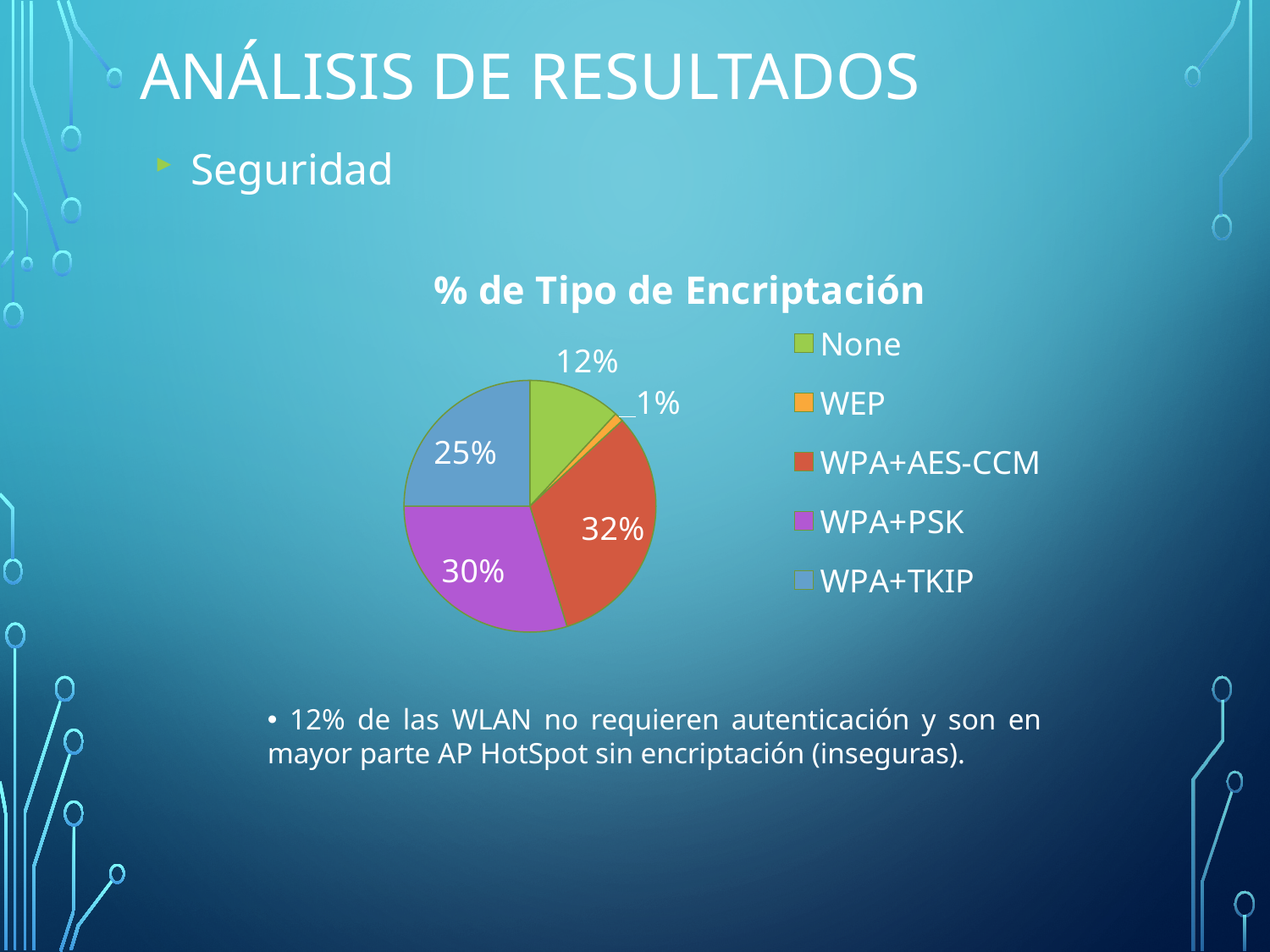
What percentage of the pie corresponds to WPA+PSK? 30% What percentage of the pie corresponds to WPA+TKIP? 25% Which encryption type has the largest share of the pie? WPA+AES-CCM Which encryption type has the smallest share of the pie? WEP Which is larger, the share for None or the share for WPA+TKIP? WPA+TKIP What percentage of the pie corresponds to WEP? 1% What type of chart is shown on the slide? pie chart What is the title of the chart? % de Tipo de Encriptación What is the difference in percentage points between WPA+PSK and WPA+TKIP? 5 How many encryption types does the legend list? 5 What percentage of the pie corresponds to WPA+AES-CCM? 32% What percentage of the pie corresponds to None? 12%